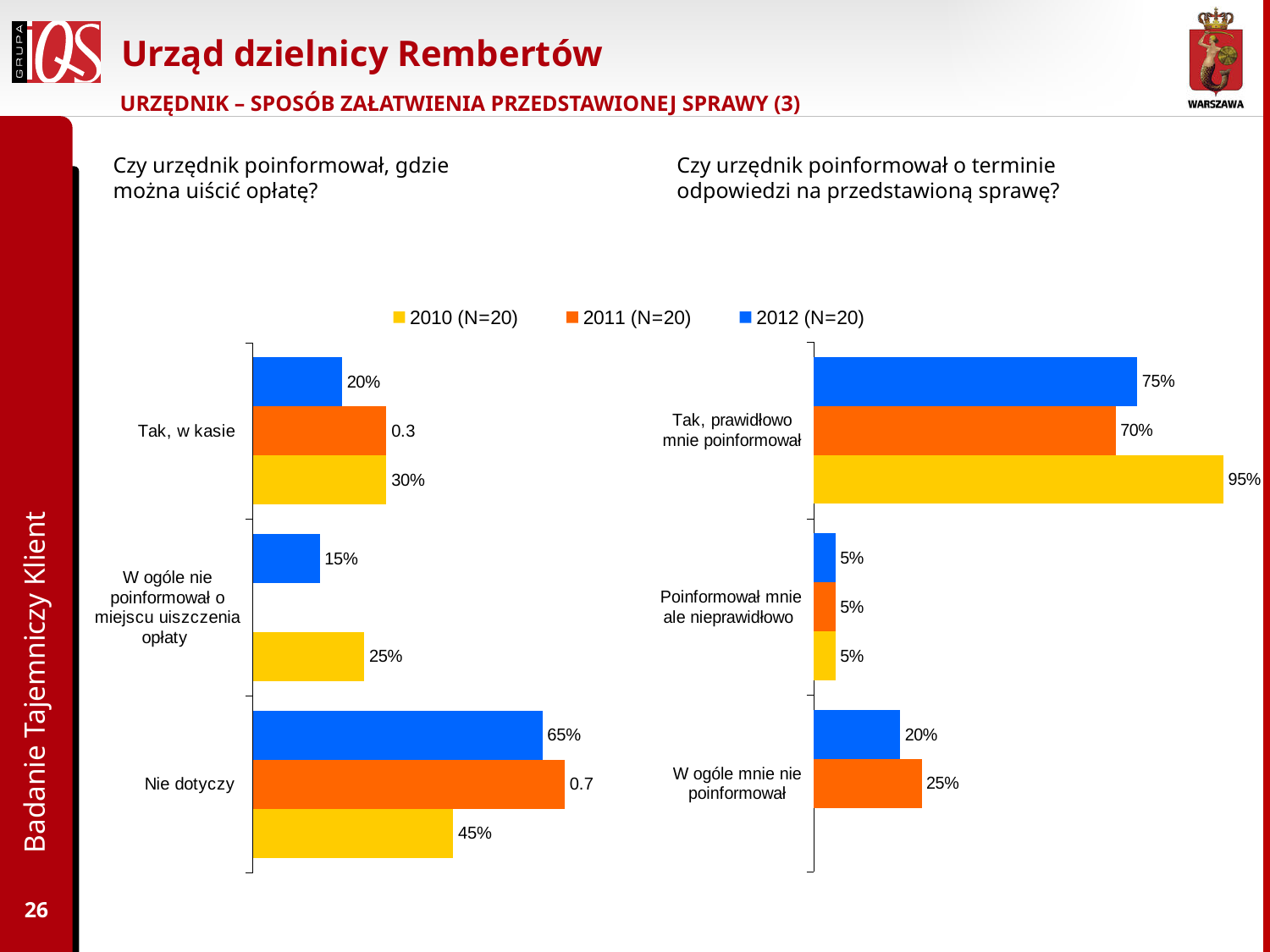
How many series does the legend list? 3 In the left chart (Czy urzędnik poinformował, gdzie można uiścić opłatę?), which is larger for 'Nie dotyczy': the 2012 (N=20) value or the 2010 (N=20) value? 2012 (N=20) In the right chart (Czy urzędnik poinformował o terminie odpowiedzi na przedstawioną sprawę?), which year has the highest value for 'Tak, prawidłowo mnie poinformował'? 2010 (N=20) In the left chart (Czy urzędnik poinformował, gdzie można uiścić opłatę?), what is the value for 'W ogóle nie poinformował o miejscu uiszczenia opłaty' in 2010 (N=20)? 25% In the left chart (Czy urzędnik poinformował, gdzie można uiścić opłatę?), which category has the lowest value for 2012 (N=20)? W ogóle nie poinformował o miejscu uiszczenia opłaty In the left chart (Czy urzędnik poinformował, gdzie można uiścić opłatę?), what value is printed for 'Tak, w kasie' in 2011 (N=20)? 0.3 In the right chart (Czy urzędnik poinformował o terminie odpowiedzi na przedstawioną sprawę?), what is the value for 'Tak, prawidłowo mnie poinformował' in 2010 (N=20)? 95% How many categories are shown in the right chart (Czy urzędnik poinformował o terminie odpowiedzi na przedstawioną sprawę?)? 3 What type of chart is used on this slide? Bar chart In the left chart (Czy urzędnik poinformował, gdzie można uiścić opłatę?), what is the value for 'Nie dotyczy' in 2012 (N=20)? 65% In the right chart (Czy urzędnik poinformował o terminie odpowiedzi na przedstawioną sprawę?), what is the difference between the 2012 (N=20) and 2011 (N=20) values for 'Tak, prawidłowo mnie poinformował'? 5% In the right chart (Czy urzędnik poinformował o terminie odpowiedzi na przedstawioną sprawę?), what is the value for 'W ogóle mnie nie poinformował' in 2011 (N=20)? 25%